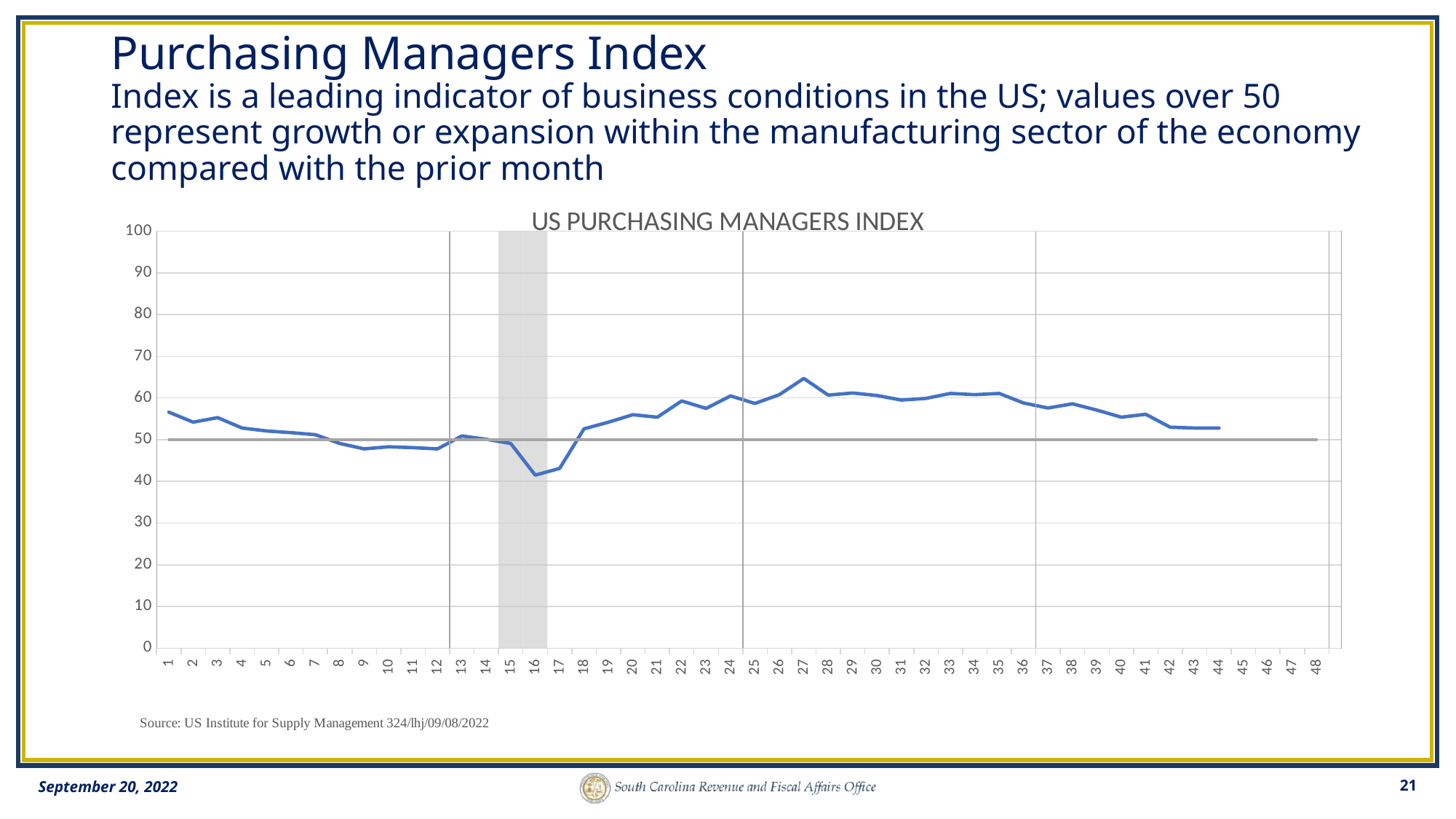
What is the title of the chart? US PURCHASING MANAGERS INDEX At which x-axis point does the line reach its highest value? 27 Which is larger, the value at point 27 or the value at point 16? point 27 At which x-axis point does the line reach its lowest value? 16 Does the line rise or fall between point 16 and point 27? rise At what value is the horizontal reference line drawn across the chart? 50 What kind of chart is shown on the slide? line chart Is the value at point 27 greater or less than 60? greater Is the value at point 1 greater or less than 50? greater Is the value at point 44 greater or less than 50? greater